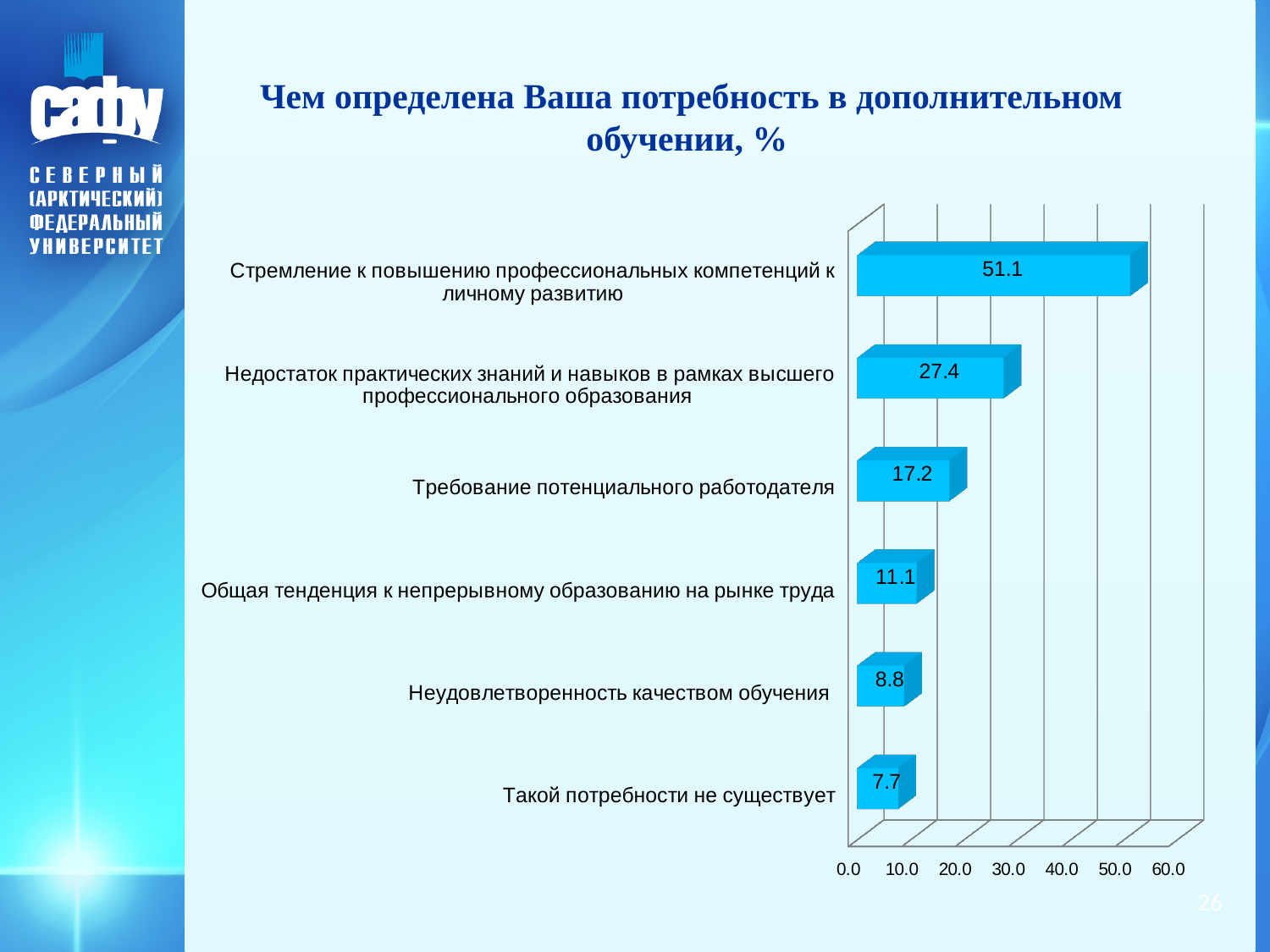
What is the value for "Стремление к повышению профессиональных компетенций к личному развитию"? 51.1 What kind of chart is shown on the slide? bar chart What is the value for "Такой потребности не существует"? 7.7 What is the value for "Требование потенциального работодателя"? 17.2 What is the difference between the values for "Недостаток практических знаний и навыков в рамках высшего профессионального образования" and "Общая тенденция к непрерывному образованию на рынке труда"? 16.3 What is the highest value shown on the x axis? 60.0 Which category has the highest value? Стремление к повышению профессиональных компетенций к личному развитию What is the title of the chart? Чем определена Ваша потребность в дополнительном обучении, % Which is larger: the value for "Неудовлетворенность качеством обучения" or the value for "Требование потенциального работодателя"? Требование потенциального работодателя How many categories are shown in the chart? 6 Is the value for "Недостаток практических знаний и навыков в рамках высшего профессионального образования" greater or less than 30.0? less Which category has the lowest value? Такой потребности не существует